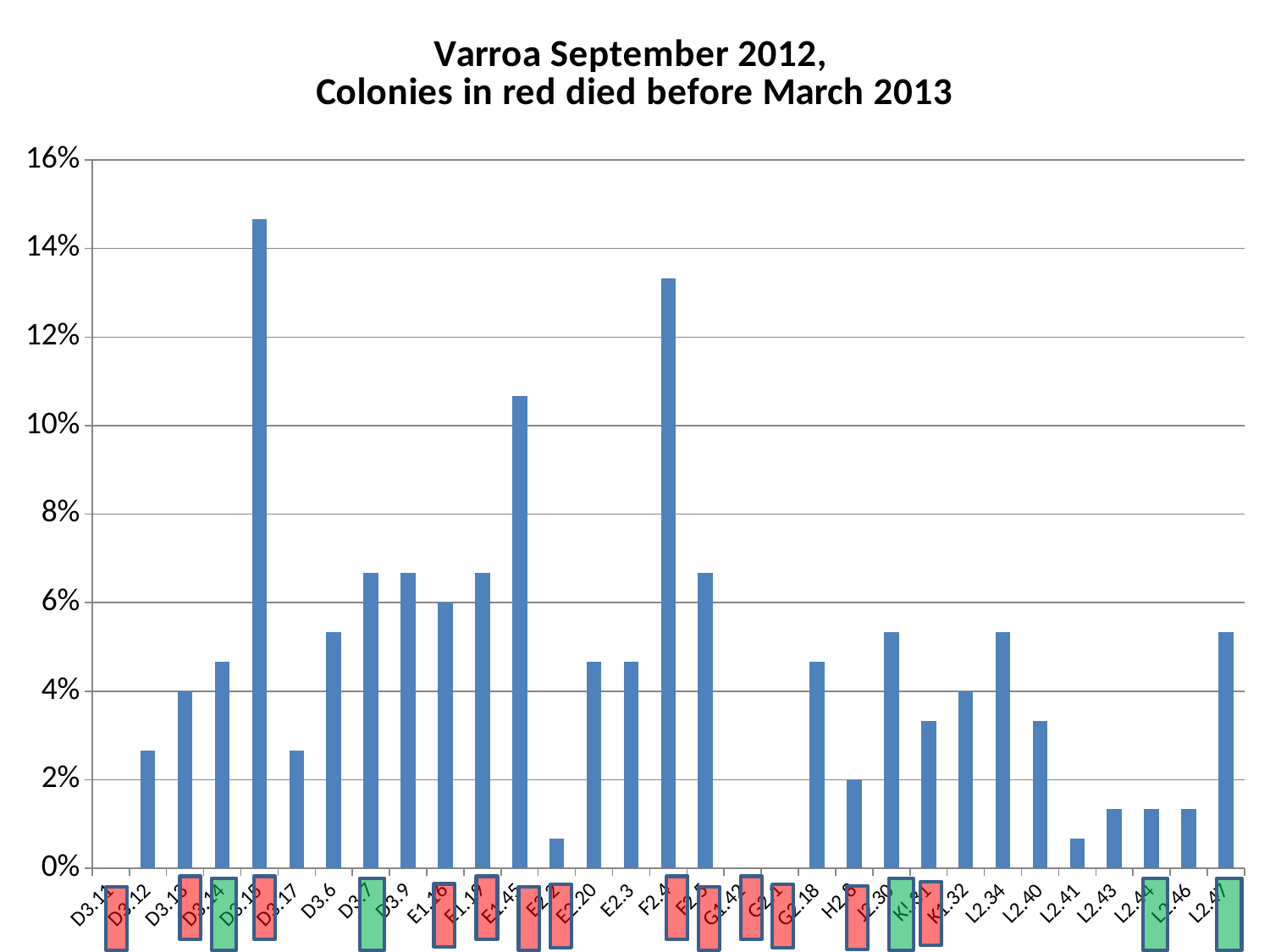
Is the value for L2.40 greater or less than 4%? less What is the title of the chart? Varroa September 2012, Colonies in red died before March 2013 Is the value for D3.6 greater or less than 4%? greater Is the value for L2.41 greater or less than 2%? less According to the chart title, what does a red label indicate? The colony died before March 2013 Which has the larger value, L2.34 or L2.43? L2.34 Which has the larger value, D3.9 or D3.12? D3.9 What kind of chart is shown on the slide? bar chart